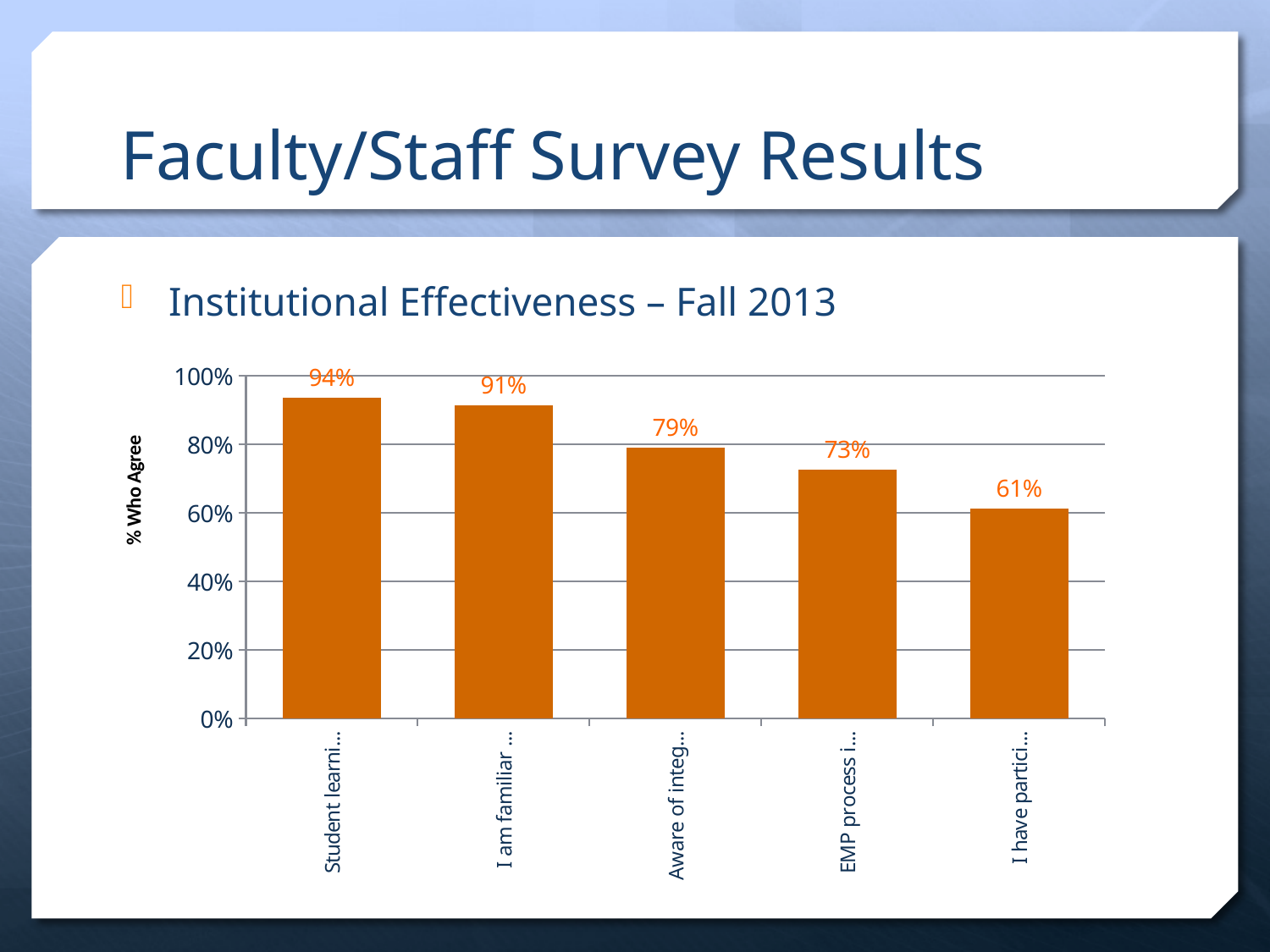
What kind of chart is shown on the slide? Bar chart Which bar has the highest value? Student learni... What is the difference between the "I am familiar ..." bar and the "EMP process i..." bar? 18% What is the value of the bar labelled "Aware of integ..."? 79% What is the value of the last bar, labelled "I have partici..."? 61% What is the difference between the values of the first bar ("Student learni...") and the last bar ("I have partici...")? 33% Which bar has the lowest value? I have partici... How many bars are shown in the chart? 5 What is the value of the first bar, labelled "Student learni..."? 94% Which is larger, the value for "Aware of integ..." or the value for "EMP process i..."? Aware of integ... What is the label of the vertical axis? % Who Agree What is the value of the bar labelled "EMP process i..."? 73%